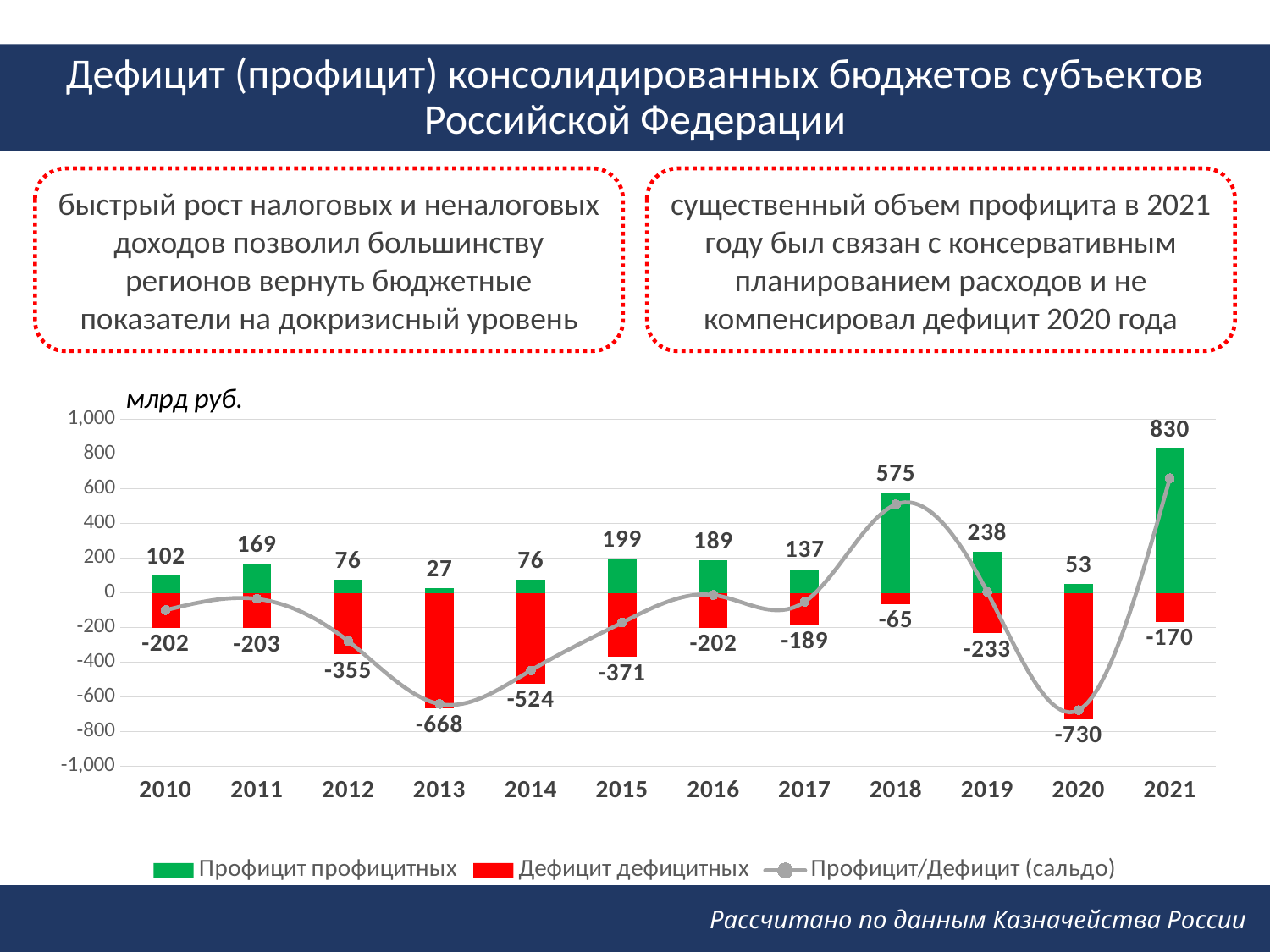
How many years are shown on the x axis? 12 What is the difference between the Профицит профицитных values for 2021 and 2018? 255 What is the value of Профицит профицитных for 2018? 575 What is the value of Дефицит дефицитных for 2013? -668 What unit is indicated above the y axis of the chart? млрд руб. What kind of chart is shown on the slide? bar and line chart How many series does the legend list? 3 Which year has the highest value for Профицит профицитных? 2021 Which year has the lowest value for Профицит профицитных? 2013 Which year has the larger Профицит профицитных value, 2015 or 2016? 2015 Is the value of the Профицит/Дефицит (сальдо) line for 2021 greater or less than 600? greater Which year has the lowest (most negative) value for Дефицит дефицитных? 2020